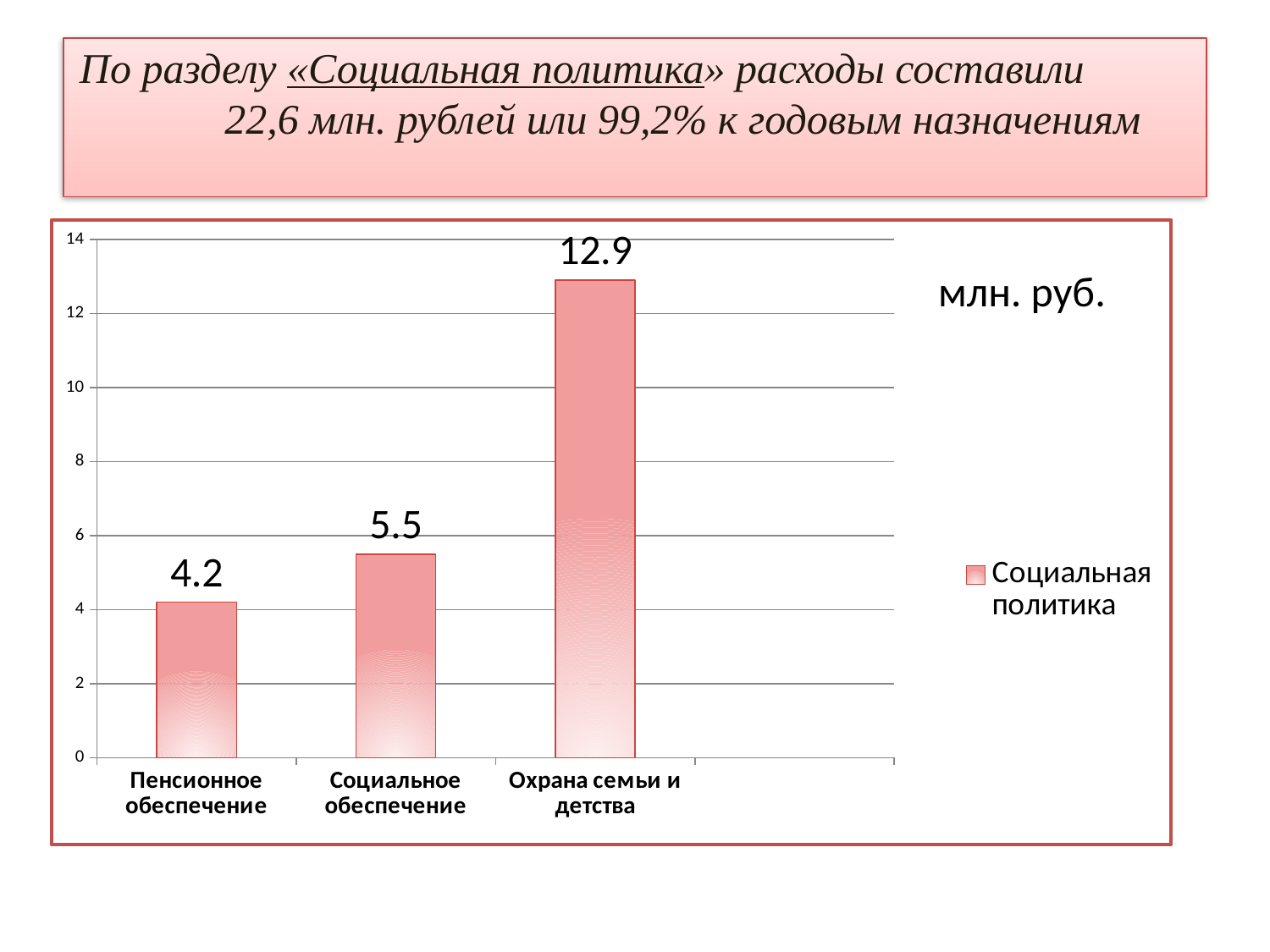
Which is larger, the value for Социальное обеспечение or the value for Пенсионное обеспечение? Социальное обеспечение What series name does the legend list? Социальная политика What is the value for Социальное обеспечение? 5.5 What is the difference between the values for Охрана семьи и детства and Социальное обеспечение? 7.4 What is the value for Пенсионное обеспечение? 4.2 How many categories are shown on the x axis? 3 What is the value for Охрана семьи и детства? 12.9 Which category has the lowest value? Пенсионное обеспечение What is the difference between the values for Социальное обеспечение and Пенсионное обеспечение? 1.3 Which category has the highest value? Охрана семьи и детства Is the value for Охрана семьи и детства greater or less than 10? greater What kind of chart is shown on the slide? bar chart